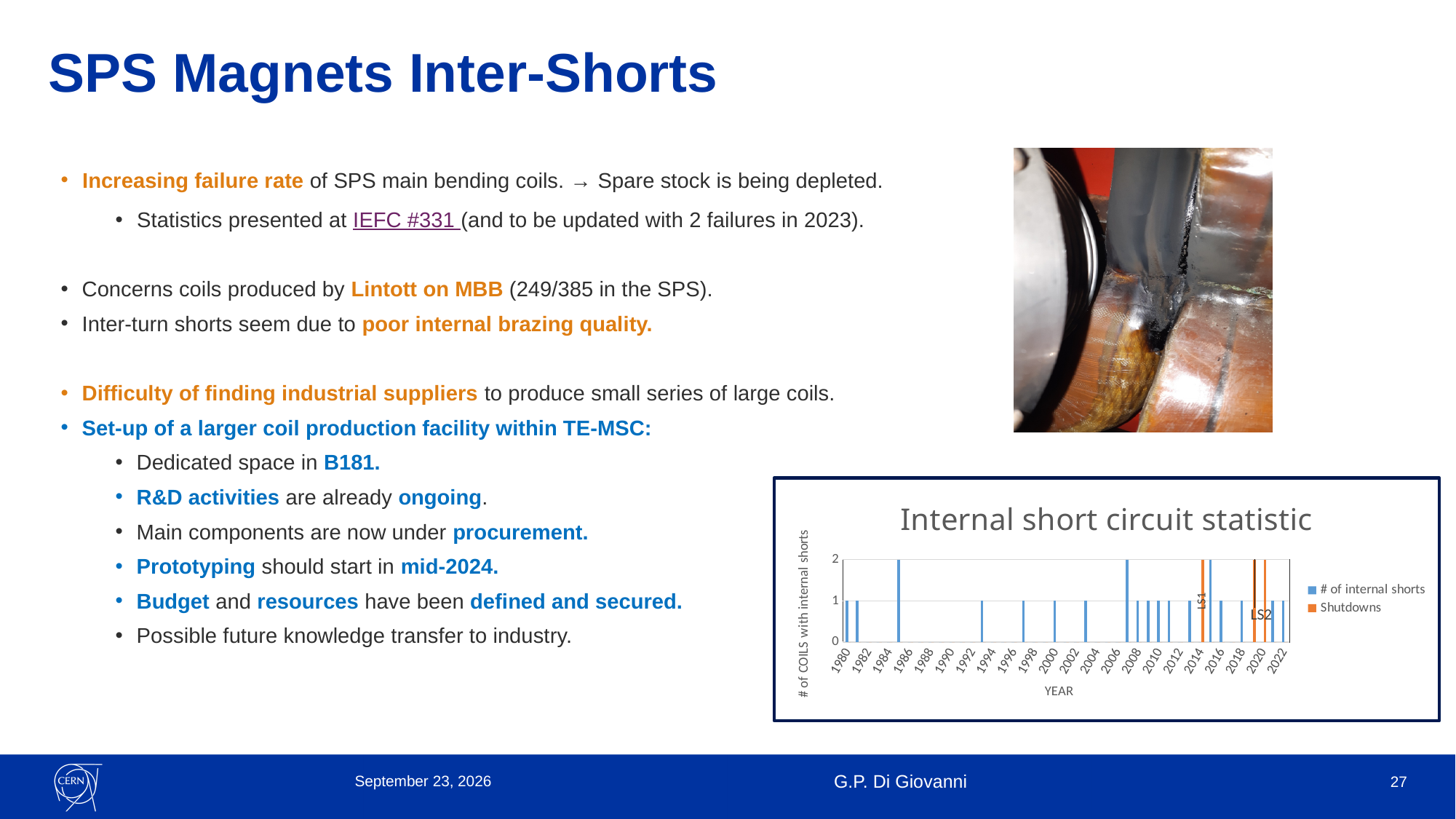
Which two shutdown periods are labelled on the chart? LS1 and LS2 Is the number of internal shorts for 1980 greater or less than 2? less What is the first year shown on the x axis of the chart? 1980 What are the two series named in the chart legend? # of internal shorts; Shutdowns What kind of chart is shown on the slide? bar chart What is the maximum value shown on the y axis of the chart? 2 What is the highest number of coils with internal shorts recorded in any single year on the chart? 2 What is the last year shown on the x axis of the chart? 2022 What is the title of the chart? Internal short circuit statistic What is the label of the x axis of the chart? YEAR How many series does the chart legend list? 2 What is the label of the y axis of the chart? # of COILS with internal shorts